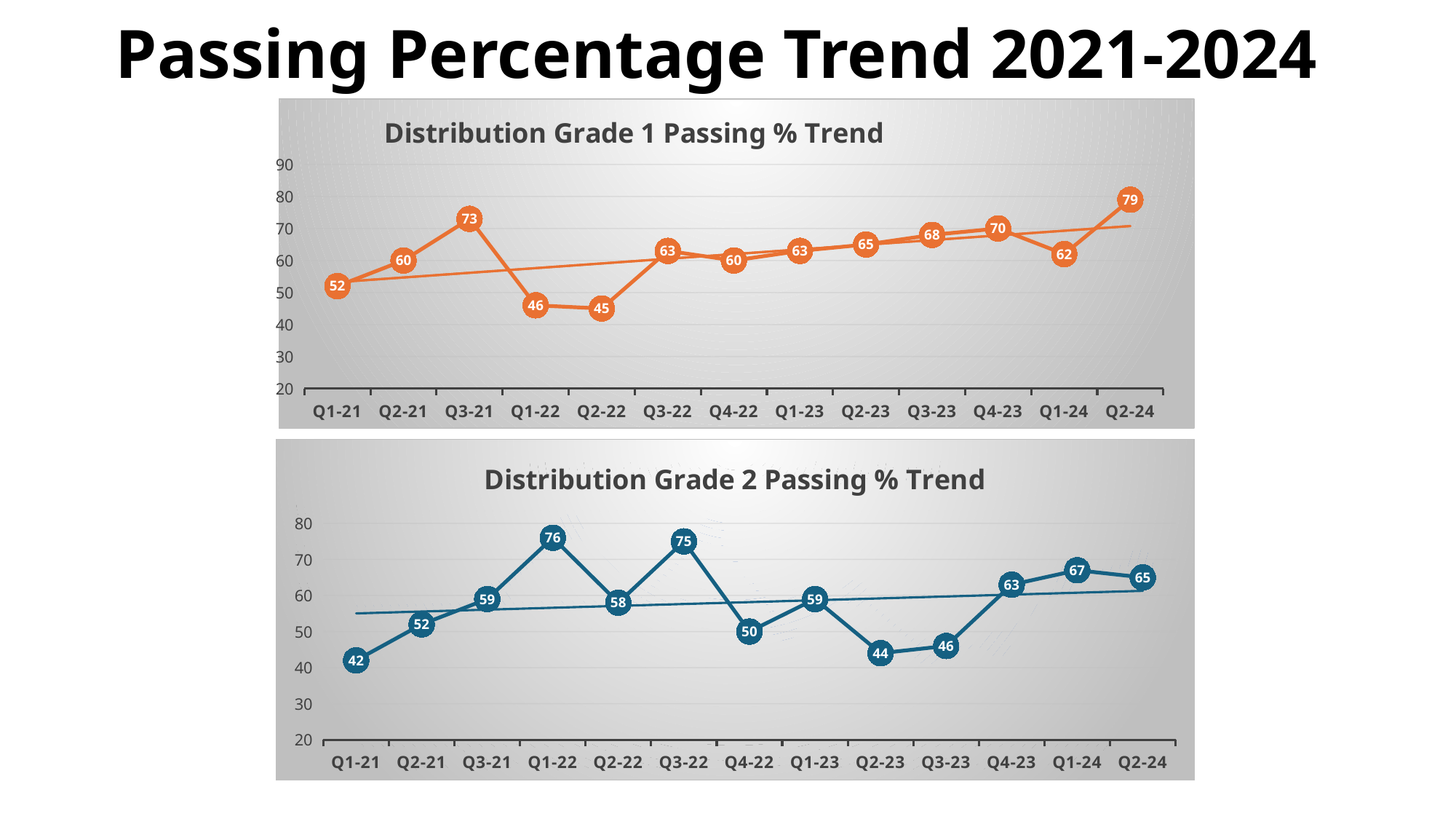
In the Distribution Grade 1 Passing % Trend chart, which quarter has the highest value? Q2-24 In the Distribution Grade 1 Passing % Trend chart, what is the difference between the values for Q2-24 and Q1-21? 27 In the Distribution Grade 2 Passing % Trend chart, which is larger, the value for Q4-22 or the value for Q1-23? Q1-23 What is the title of the slide? Passing Percentage Trend 2021-2024 In the Distribution Grade 1 Passing % Trend chart, which quarter has the lowest value? Q2-22 In the Distribution Grade 2 Passing % Trend chart, what is the value for Q1-22? 76 In the Distribution Grade 2 Passing % Trend chart, which quarter has the lowest value? Q1-21 In the Distribution Grade 1 Passing % Trend chart, how many quarters are plotted on the x axis? 13 In the Distribution Grade 1 Passing % Trend chart, what is the value for Q3-21? 73 In the Distribution Grade 2 Passing % Trend chart, what is the difference between the values for Q3-22 and Q4-22? 25 In the Distribution Grade 2 Passing % Trend chart, which quarter has the highest value? Q1-22 What kind of chart is the Distribution Grade 1 Passing % Trend chart? Line chart